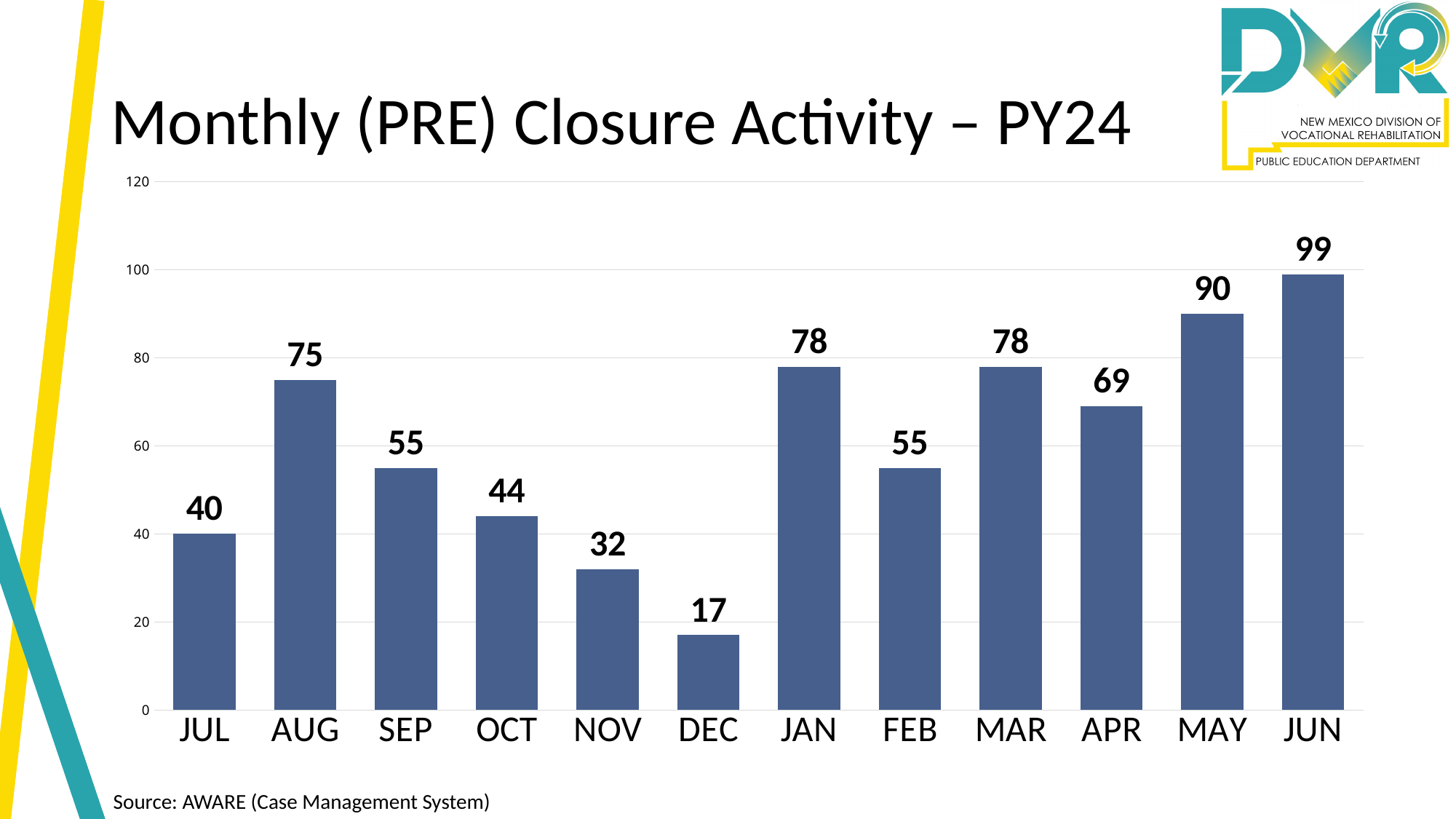
What is the title of the chart? Monthly (PRE) Closure Activity – PY24 Is the value for APR greater or less than 60? greater What is the difference between the values for JAN and DEC? 61 Which month has the lowest value? DEC What is the value for DEC? 17 What kind of chart is shown on the slide? bar chart How many months are shown on the x axis? 12 What is the value for AUG? 75 What is the value for MAR? 78 Which month has the highest value? JUN What is the difference between the values for JUN and MAY? 9 Which is larger, the value for OCT or the value for NOV? OCT